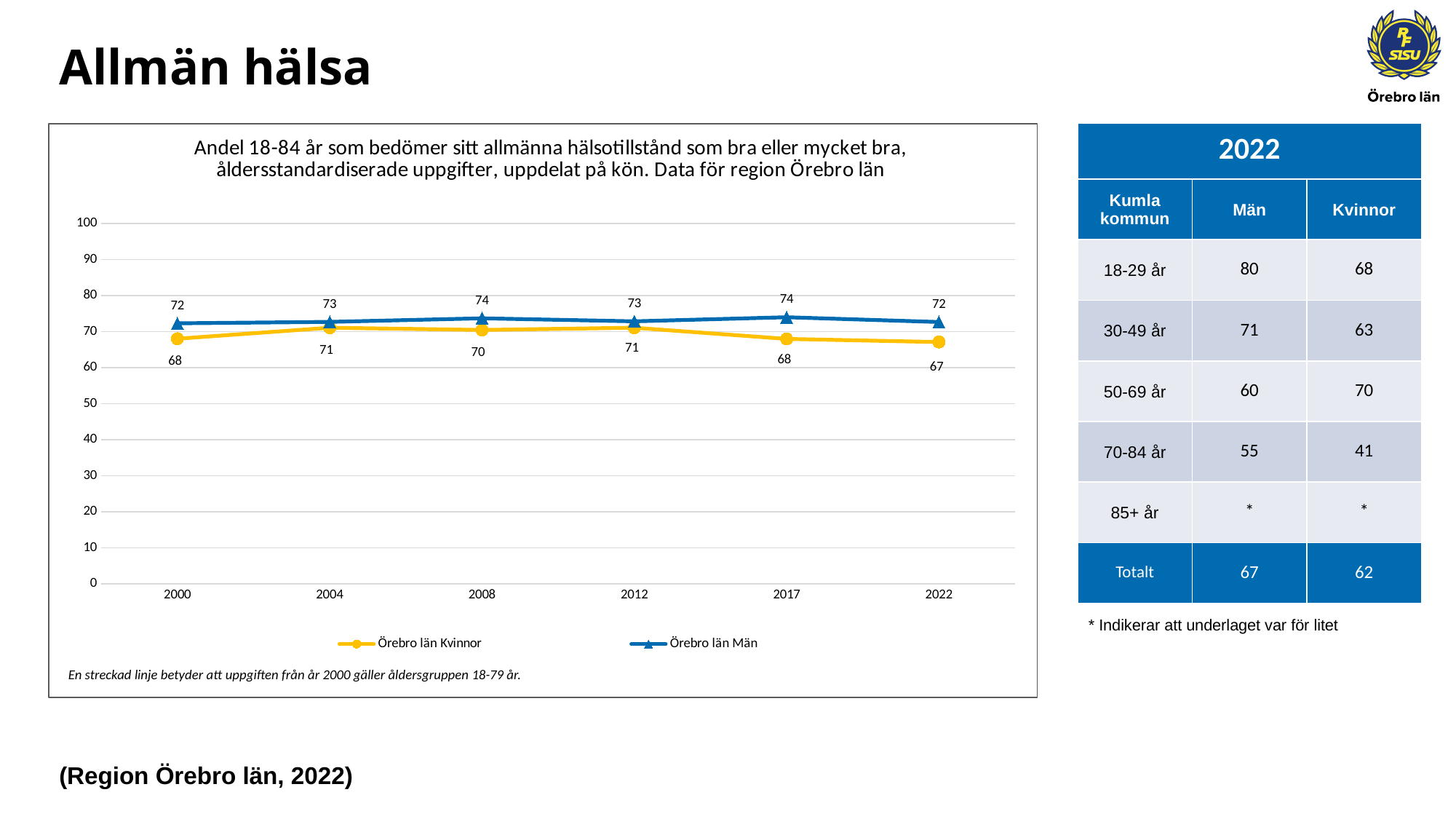
Which series has the higher value in 2017, Örebro län Män or Örebro län Kvinnor? Örebro län Män Is the value for Örebro län Kvinnor in 2004 greater or less than 60? greater How many years are plotted along the x axis of the chart? 6 What is the value for Örebro län Män in 2008? 74 What is the value for Örebro län Kvinnor in 2000? 68 What is the value for Örebro län Kvinnor in 2022? 67 What is the value for Örebro län Män in 2012? 73 What kind of chart is shown on the slide? Line chart In which year is the value for Örebro län Kvinnor lowest? 2022 How many series does the chart legend list? 2 Which colour is used for the Örebro län Kvinnor line in the chart? Yellow What is the difference between Örebro län Män and Örebro län Kvinnor in 2022? 5